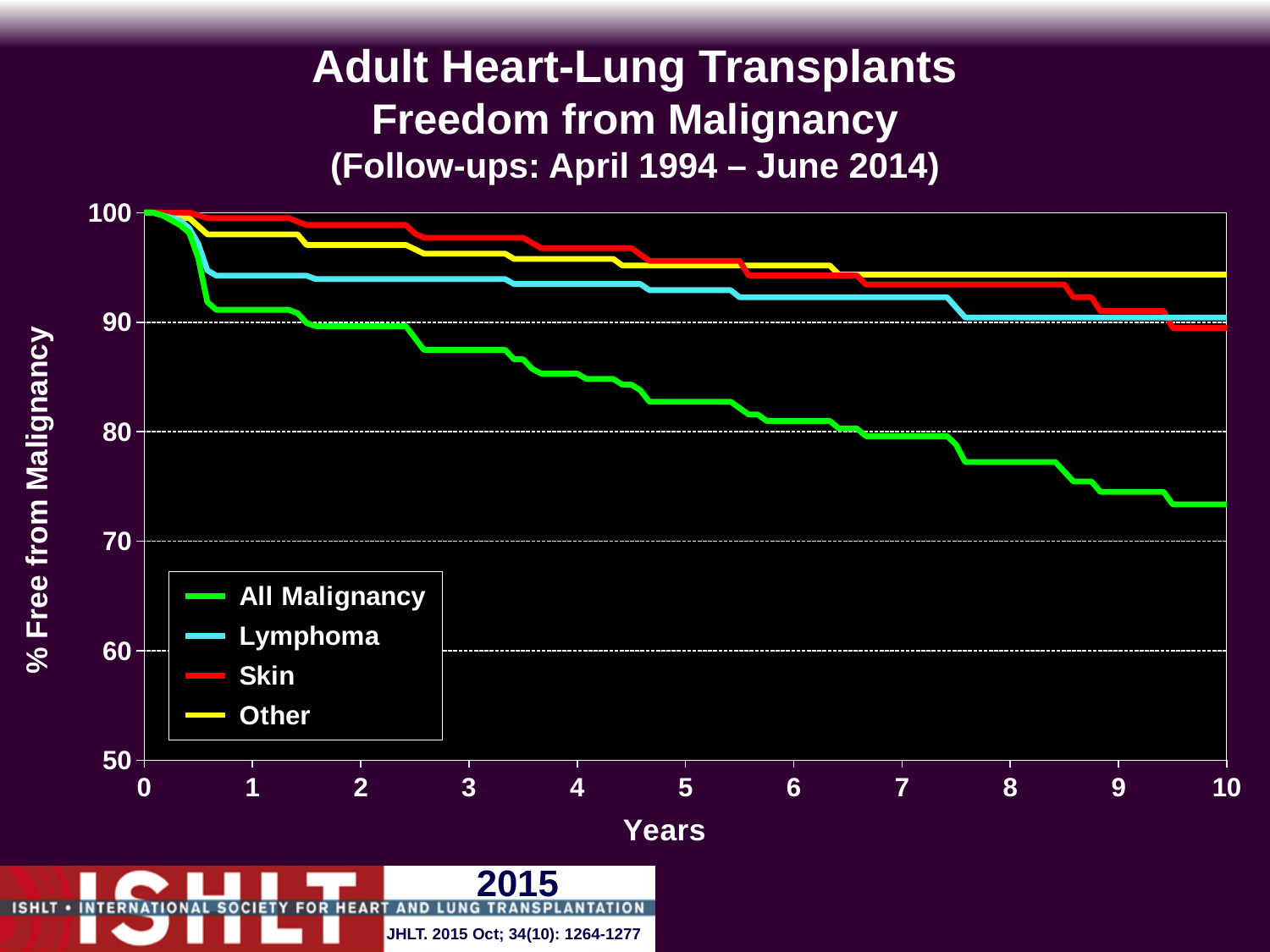
Do the values for All Malignancy rise or fall as years increase? fall How many series does the legend list? 4 Is the value for All Malignancy at 10 years greater or less than 70? greater Which series has the highest % free from malignancy at 10 years? Other Is the value for All Malignancy at 5 years greater or less than 80? greater Is the value for All Malignancy at 10 years greater or less than 80? less What kind of chart is shown on the slide? line chart At 10 years, which is larger: the value for Other or the value for All Malignancy? Other Which series is shown in green in the legend? All Malignancy Which series has the lowest % free from malignancy at 10 years? All Malignancy What is the label of the x axis? Years